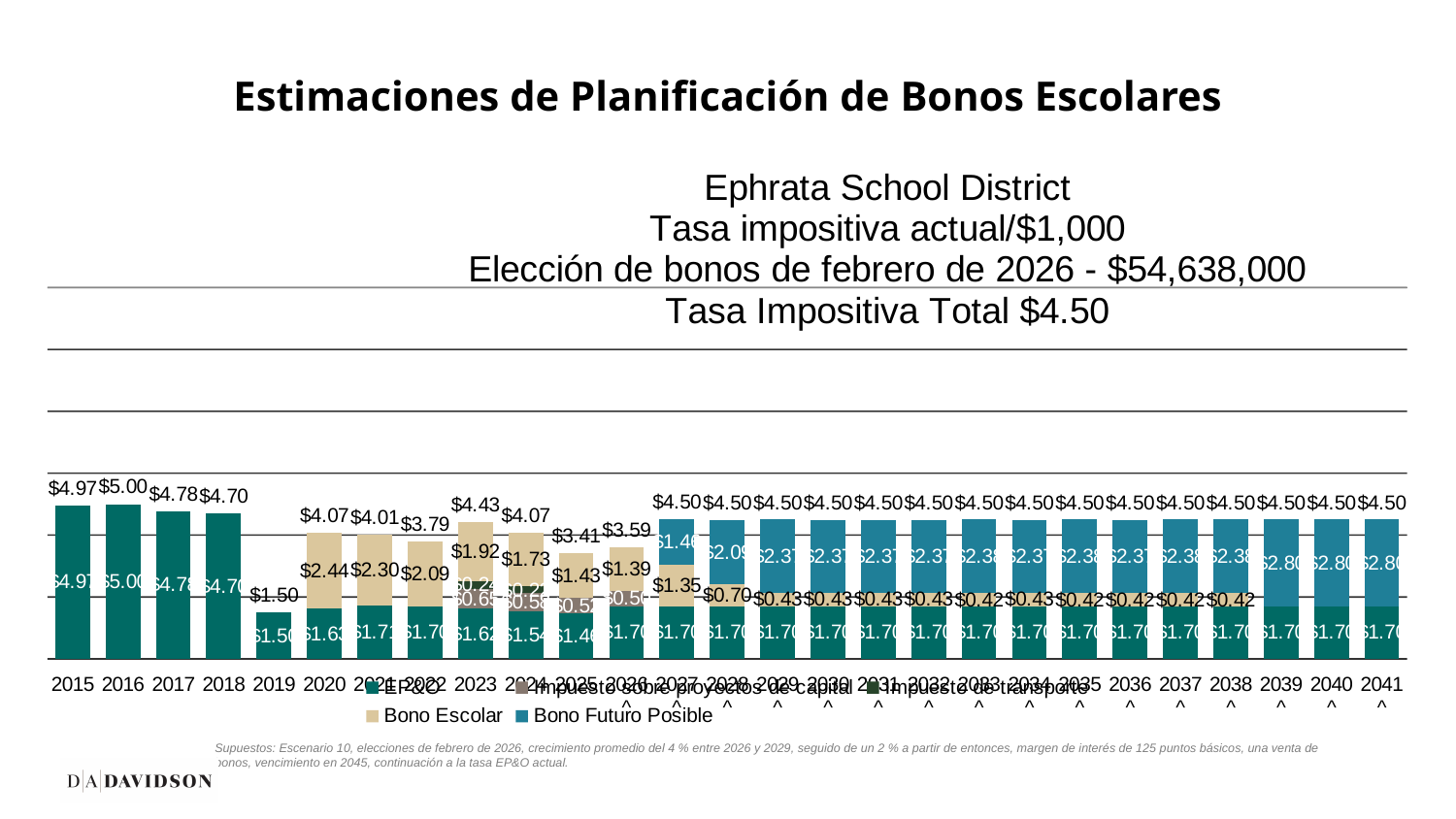
What is the total tax rate labeled above the bar for 2023? $4.43 Which year has a larger total tax rate, 2022 or 2023? 2023 What is the Bono Escolar value for 2020? $2.44 How many years are shown along the x axis of the chart? 27 What kind of chart is shown on the slide? bar chart What is the difference between the total tax rate for 2016 and the total tax rate for 2019? $3.50 Which year has the highest total tax rate in the chart? 2016 What is the total tax rate labeled above the bar for 2020? $4.07 What is the total tax rate labeled above the bar for 2019? $1.50 Which year has the lowest total tax rate in the chart? 2019 How many series does the chart legend list? 5 Do the total tax rates rise, fall, or stay flat from 2027 through 2041? stay flat